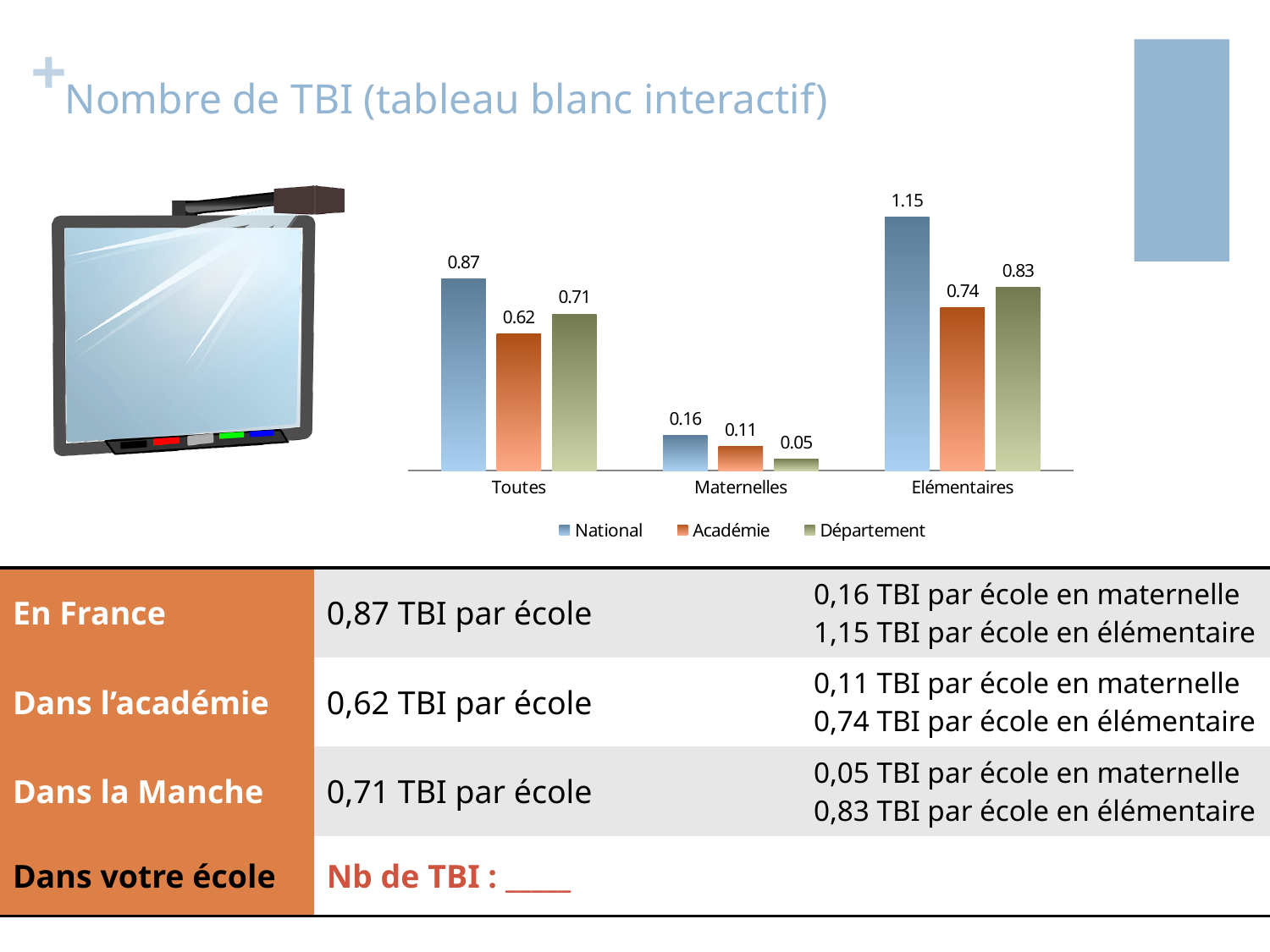
Which category has the lowest Département value? Maternelles What is the difference between the Département values for Elémentaires and Maternelles? 0.78 What is the Académie value for Toutes? 0.62 Which series is shown in orange in the legend? Académie What is the Département value for Maternelles? 0.05 What is the difference between the National and Académie values for Toutes? 0.25 Which category has the highest National value? Elémentaires What kind of chart is shown on the slide? Bar chart For Elémentaires, which is larger: the Académie value or the Département value? Département What is the National value for Elémentaires? 1.15 How many categories are shown on the x axis? 3 How many series does the legend list? 3